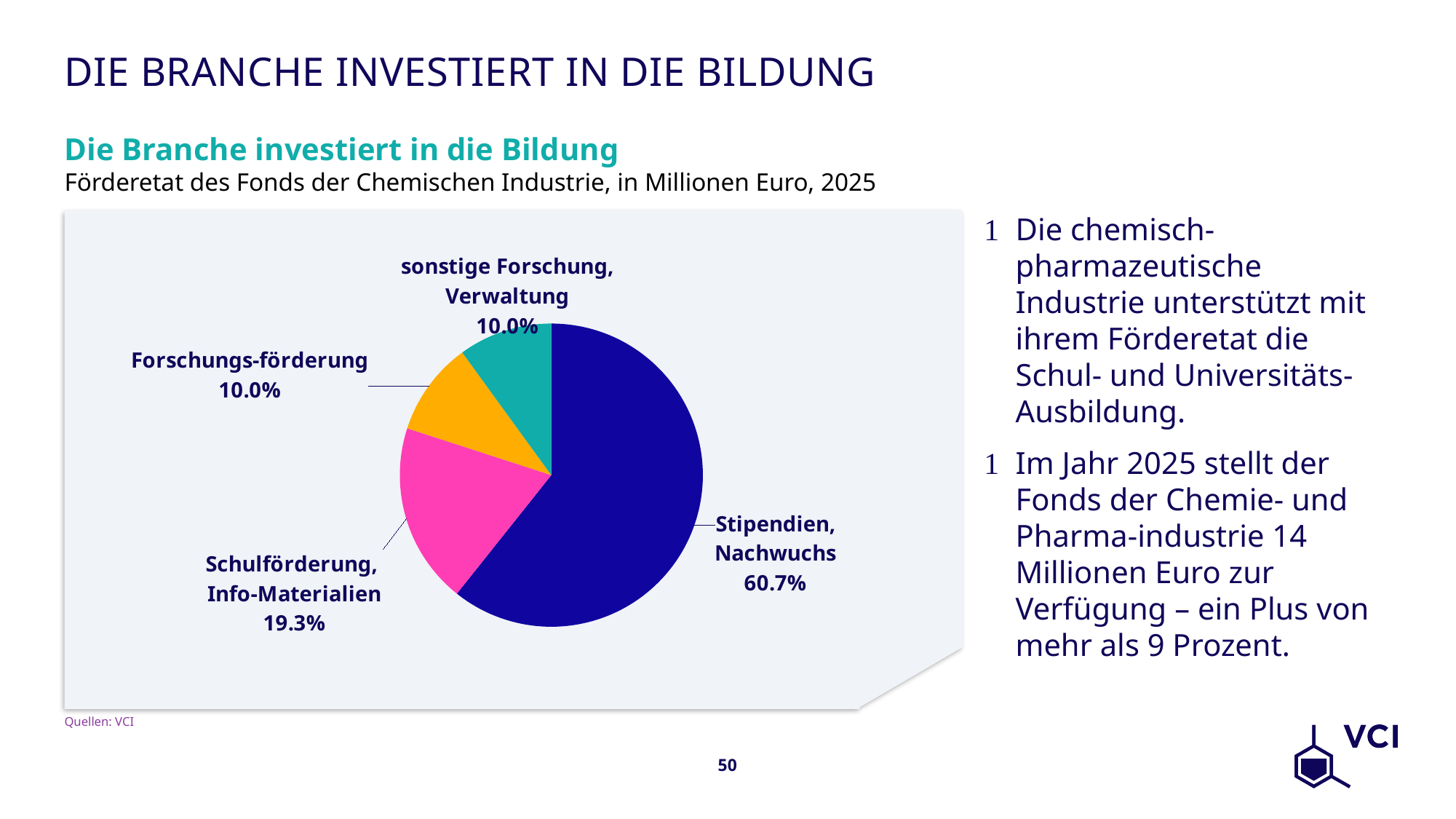
What share of the pie does Stipendien, Nachwuchs have? 60.7% Which category has the largest slice of the pie? Stipendien, Nachwuchs What colour is the slice for Stipendien, Nachwuchs? dark blue Which is larger: the share for Schulförderung, Info-Materialien or the share for Forschungs-förderung? Schulförderung, Info-Materialien What is the difference in percentage points between Stipendien, Nachwuchs and Schulförderung, Info-Materialien? 41.4 What is the title of the chart? Die Branche investiert in die Bildung How many slices does the pie chart have? 4 What share of the pie does sonstige Forschung, Verwaltung have? 10.0% What share of the pie does Schulförderung, Info-Materialien have? 19.3% Is the share for Stipendien, Nachwuchs greater or less than 50%? greater What kind of chart is shown on the slide? pie chart